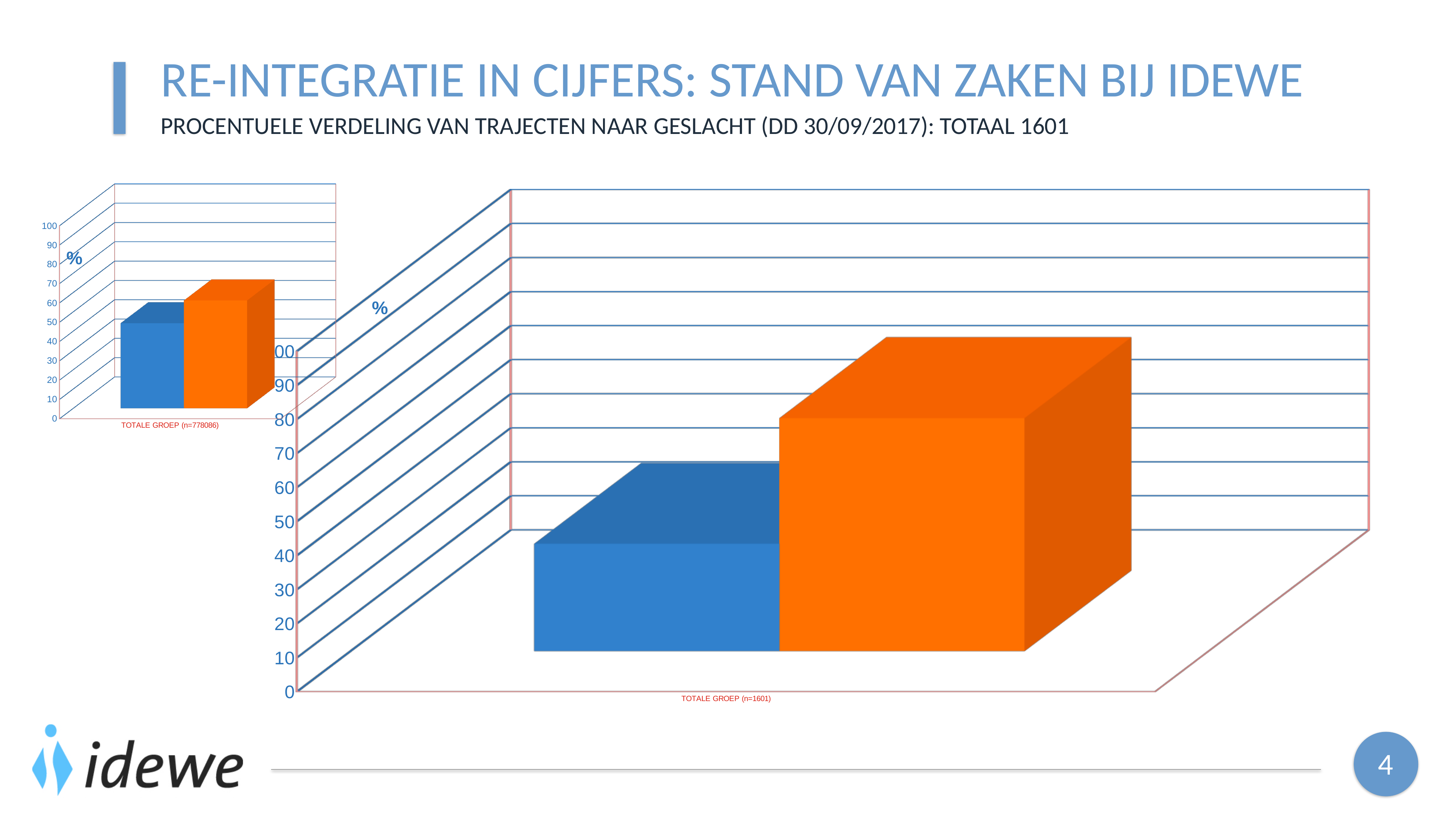
What is the category label on the x axis of the large chart on the right? TOTALE GROEP (n=1601) In the large chart on the right, is the value of the orange bar greater or less than 50? greater In the large chart on the right, is the value of the blue bar greater or less than 50? less How many categories are shown on the x axis of the large chart on the right? 1 In the small chart on the left, is the value of the blue bar greater or less than 60? less In the small chart on the left, which bar is taller, the blue bar or the orange bar? the orange bar What unit label is shown on the vertical axis of the small chart on the left? % In the large chart on the right, which bar is taller, the blue bar or the orange bar? the orange bar What kind of chart is the large chart on the right of the slide? bar chart How many bars are plotted in the small chart on the left? 2